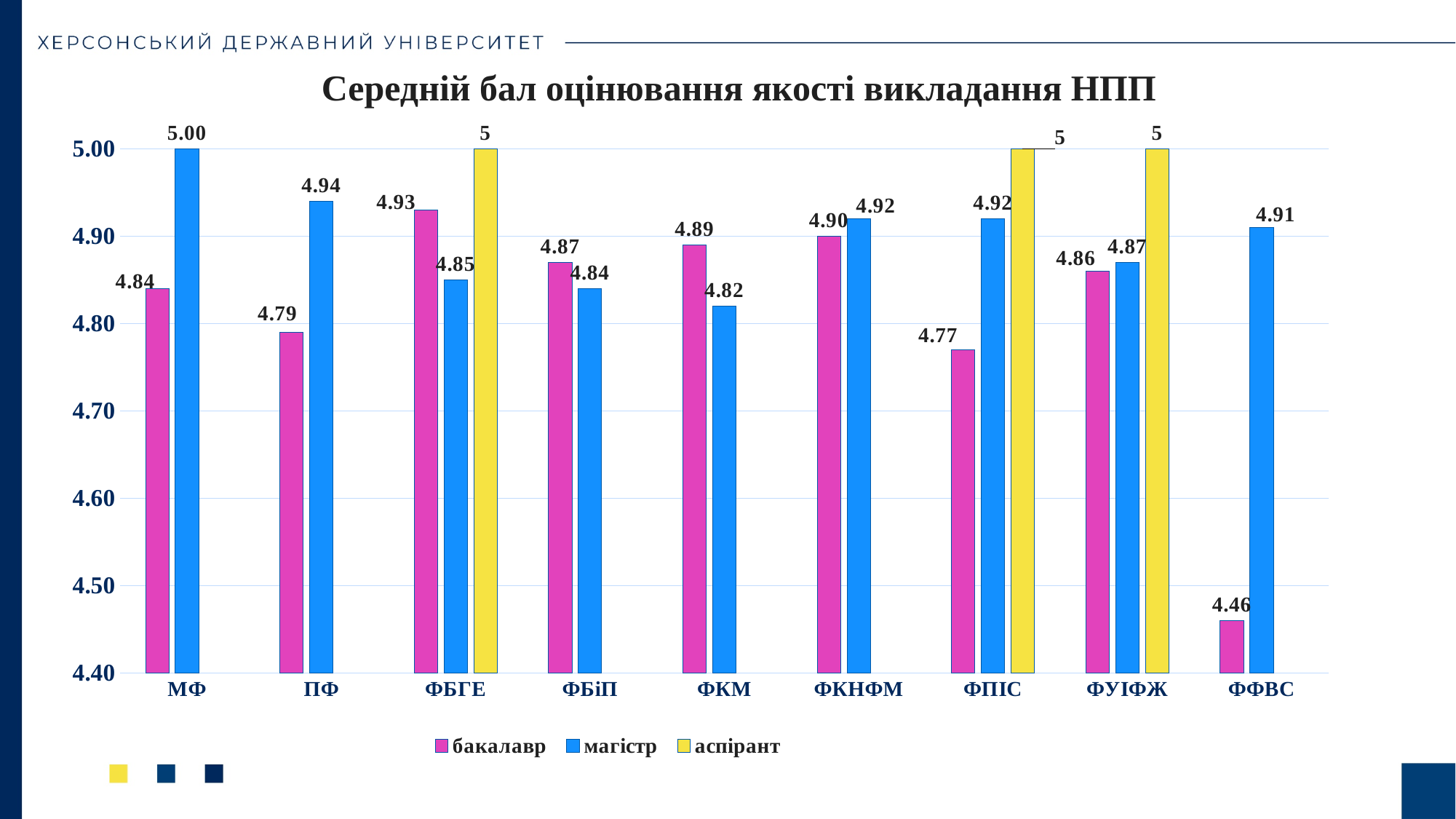
How many series does the legend list? 3 What is the бакалавр value for ФФВС? 4.46 For ФКМ, which is larger: the бакалавр value or the магістр value? бакалавр What is the difference between the магістр and бакалавр values for ФФВС? 0.45 What is the difference between the магістр and бакалавр values for ПФ? 0.15 What is the аспірант value for ФБГЕ? 5 What kind of chart is shown on the slide? bar chart Is the бакалавр value for ФПІС greater or less than 4.80? less What is the магістр value for ПФ? 4.94 How many categories are shown on the x axis? 9 Which category has the highest бакалавр value? ФБГЕ Which category has the lowest бакалавр value? ФФВС